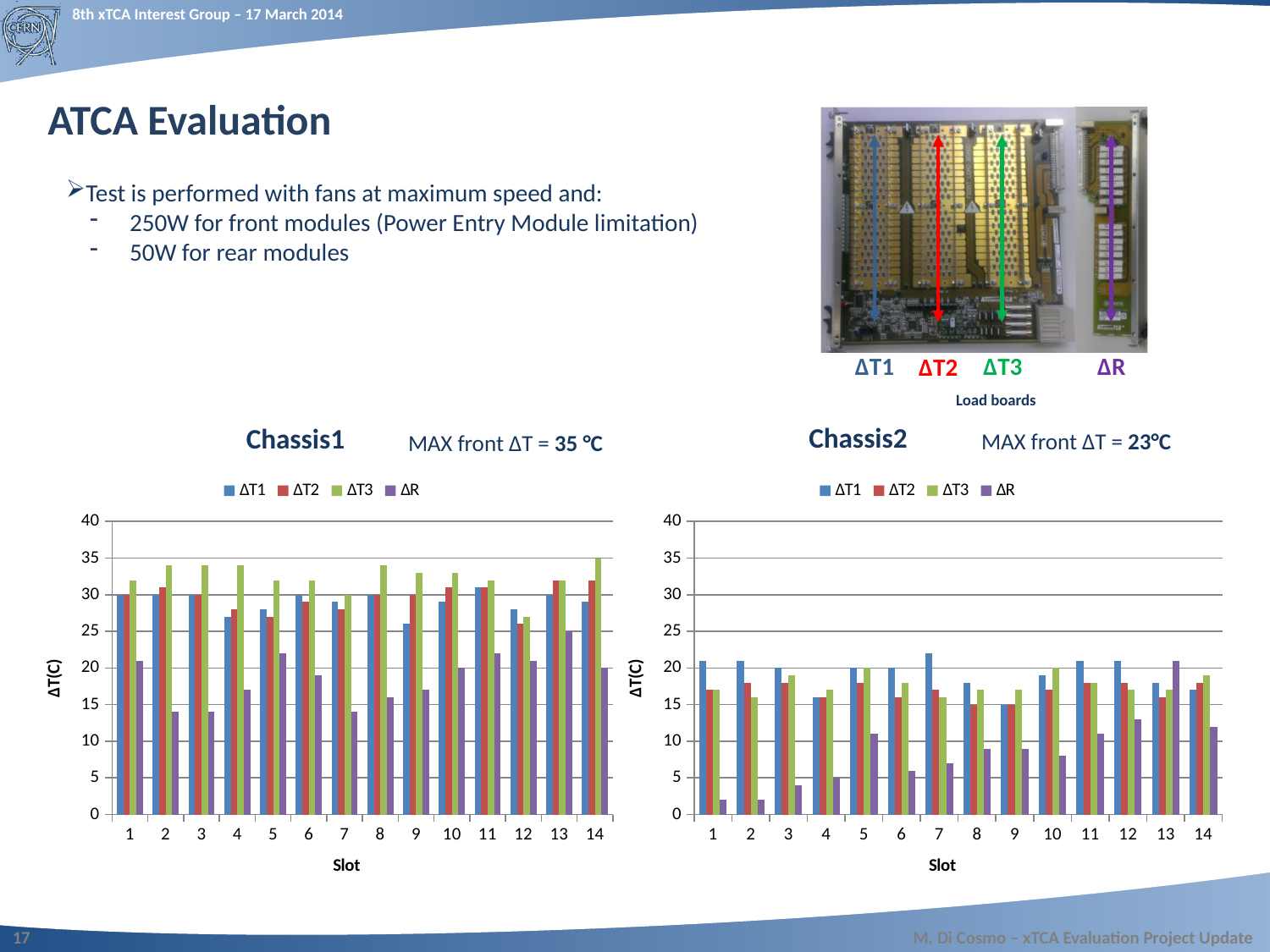
In the Chassis1 chart, which slot has the highest ΔR value? 13 What is the y-axis label on the Chassis2 chart? ΔT(C) In the Chassis1 chart, is the ΔT3 value for slot 14 greater or less than 30? greater In the Chassis2 chart, do the ΔR values generally rise or fall from slot 1 to slot 12? rise In the Chassis2 chart, is the ΔR value for slot 1 greater or less than 5? less In the Chassis2 chart, which is larger for slot 13: ΔR or ΔT2? ΔR In the Chassis2 chart, which slot has the highest ΔR value? 13 What kind of chart is the Chassis1 chart? bar chart In the Chassis1 chart, is the ΔR value for slot 13 greater or less than 20? greater How many series does the legend of the Chassis2 chart list? 4 In the Chassis1 chart, which is larger for slot 1: ΔT3 or ΔR? ΔT3 How many slots are plotted on the x axis of the Chassis1 chart? 14